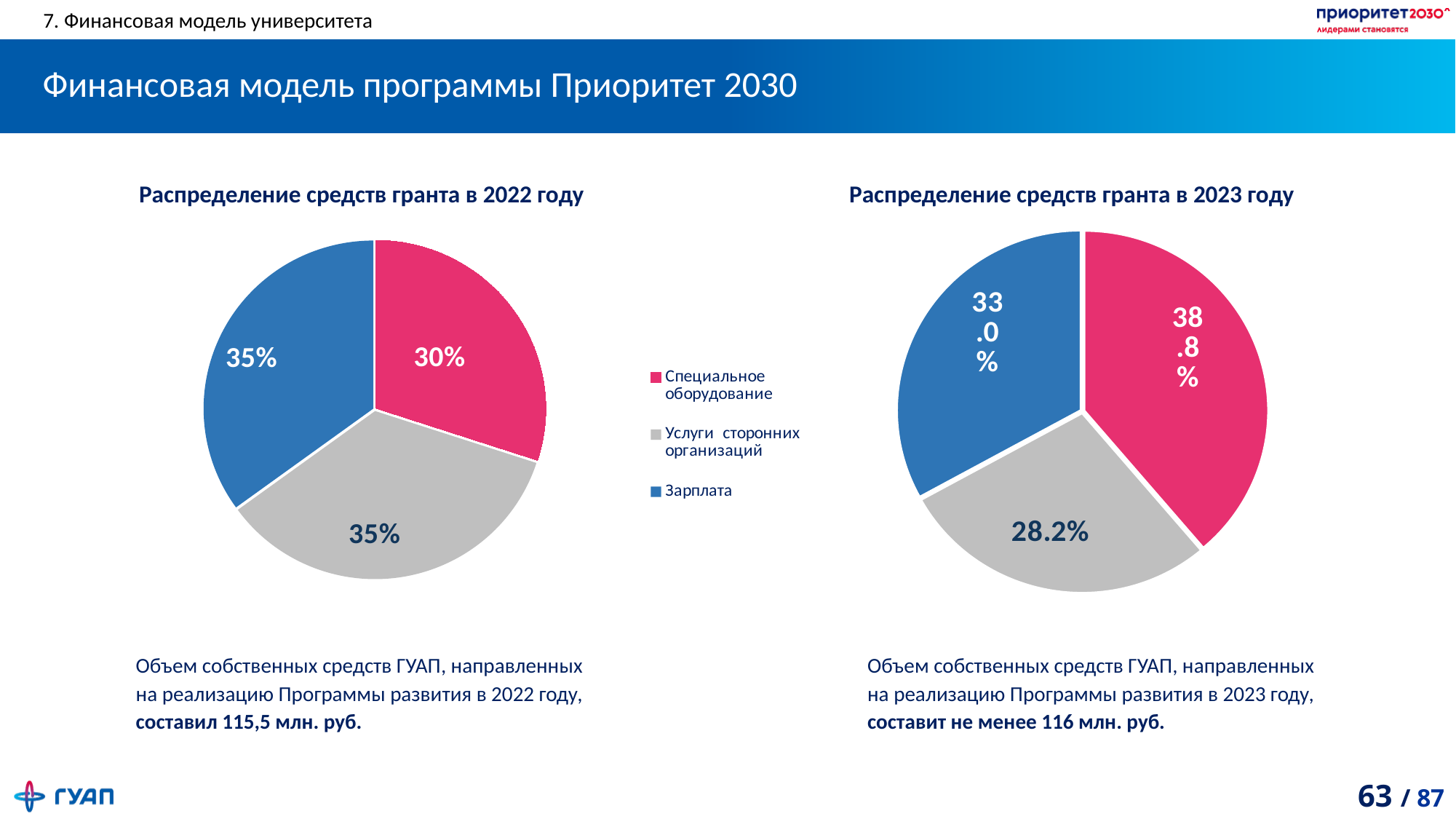
In the 2023 chart, which category has the largest share? Специальное оборудование In the 2023 chart, which category has the smallest share? Услуги сторонних организаций In the 2023 chart, what share goes to 'Зарплата'? 33.0% In the 2022 chart, which category has the smallest share? Специальное оборудование Which colour represents 'Зарплата' in the pie charts? blue In the 2023 chart, what share goes to 'Услуги сторонних организаций'? 28.2% In the 2022 chart ('Распределение средств гранта в 2022 году'), what share goes to 'Специальное оборудование'? 30% In the 2023 chart, what is the difference between the shares of 'Специальное оборудование' and 'Услуги сторонних организаций'? 10.6% In the 2022 chart, what share goes to 'Зарплата'? 35% What kind of chart is used for 'Распределение средств гранта в 2022 году'? pie chart How many categories does the legend list for the pie charts? 3 In the 2023 chart ('Распределение средств гранта в 2023 году'), what share goes to 'Специальное оборудование'? 38.8%